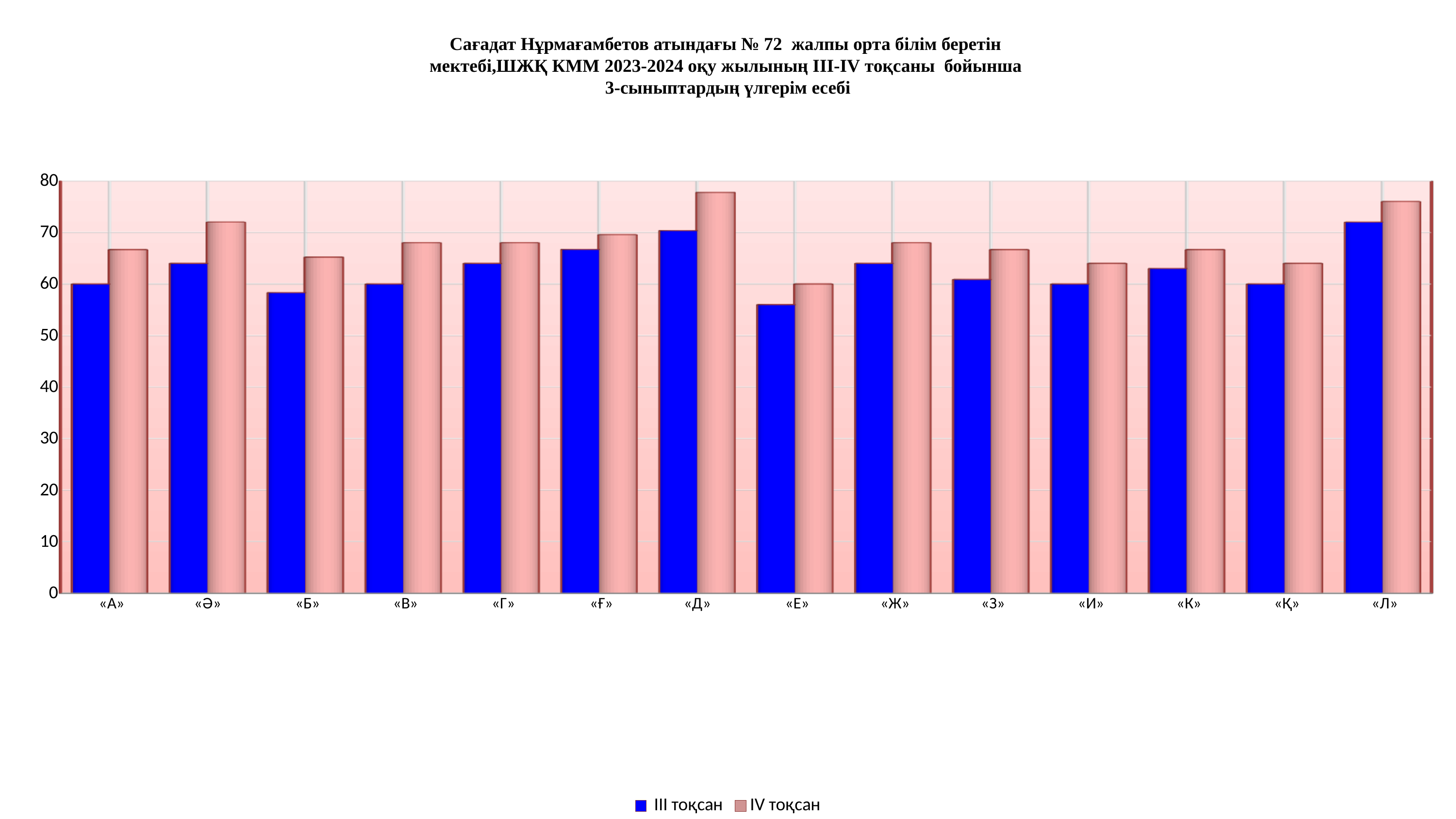
Which category has the lowest value for IV тоқсан? «Е» How many series does the legend list? 2 What kind of chart is shown on the slide? bar chart Which category has the lowest value for III тоқсан? «Е» For «Е», which series has the larger value: III тоқсан or IV тоқсан? IV тоқсан Which series is drawn in blue? III тоқсан How many class categories are shown on the x axis? 14 Is the IV тоқсан value for «Д» greater or less than 70? greater Is the IV тоқсан value for «Ә» greater or less than 70? greater Which is larger for III тоқсан: «Ә» or «Б»? «Ә» Is the III тоқсан value for «Л» greater or less than 70? greater